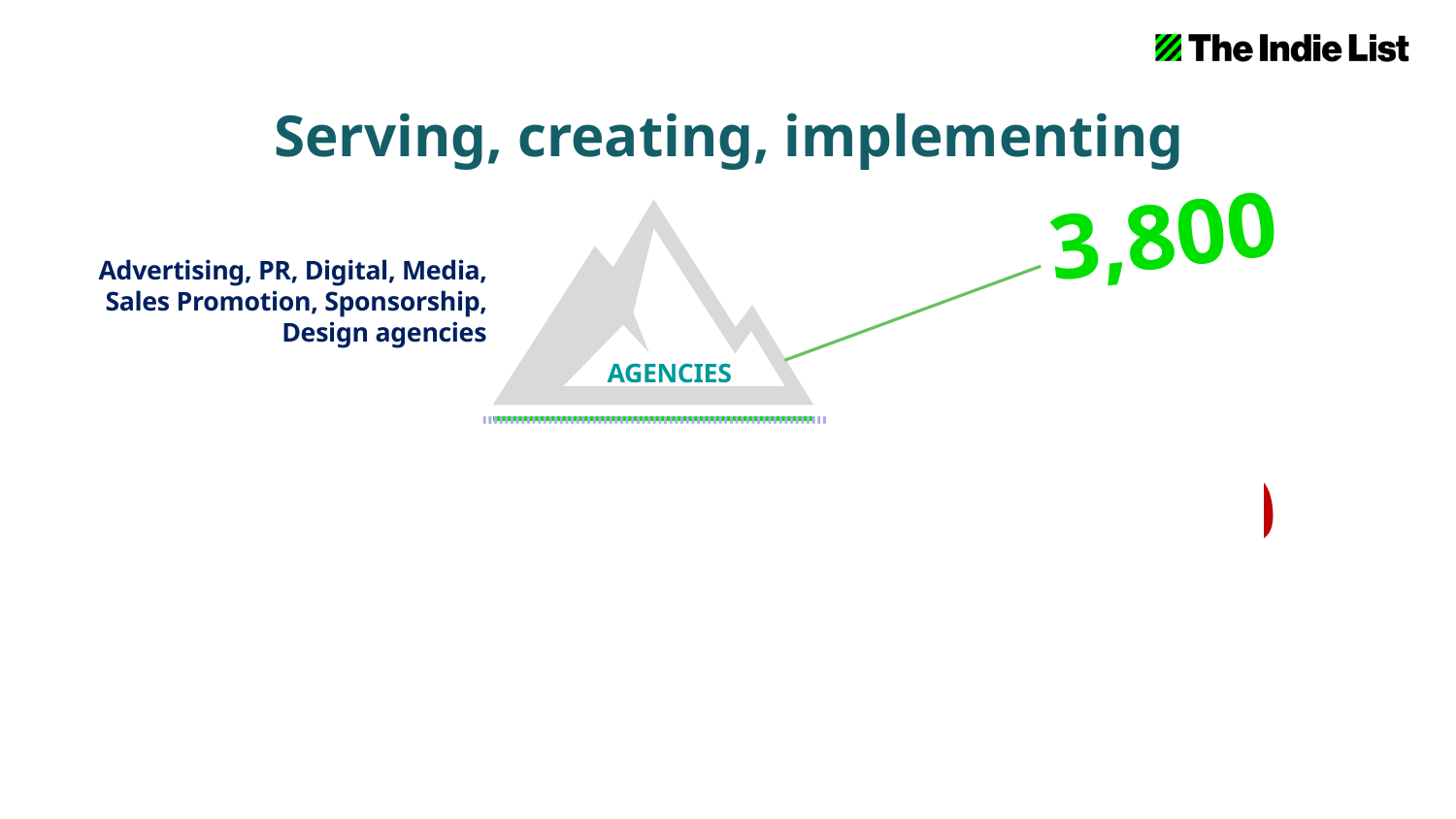
Is the value shown for AGENCIES greater or less than 3,000? greater What label appears on the mountain graphic? AGENCIES What value is shown for AGENCIES on the slide? 3,800 How many categories are labelled on the mountain graphic? 1